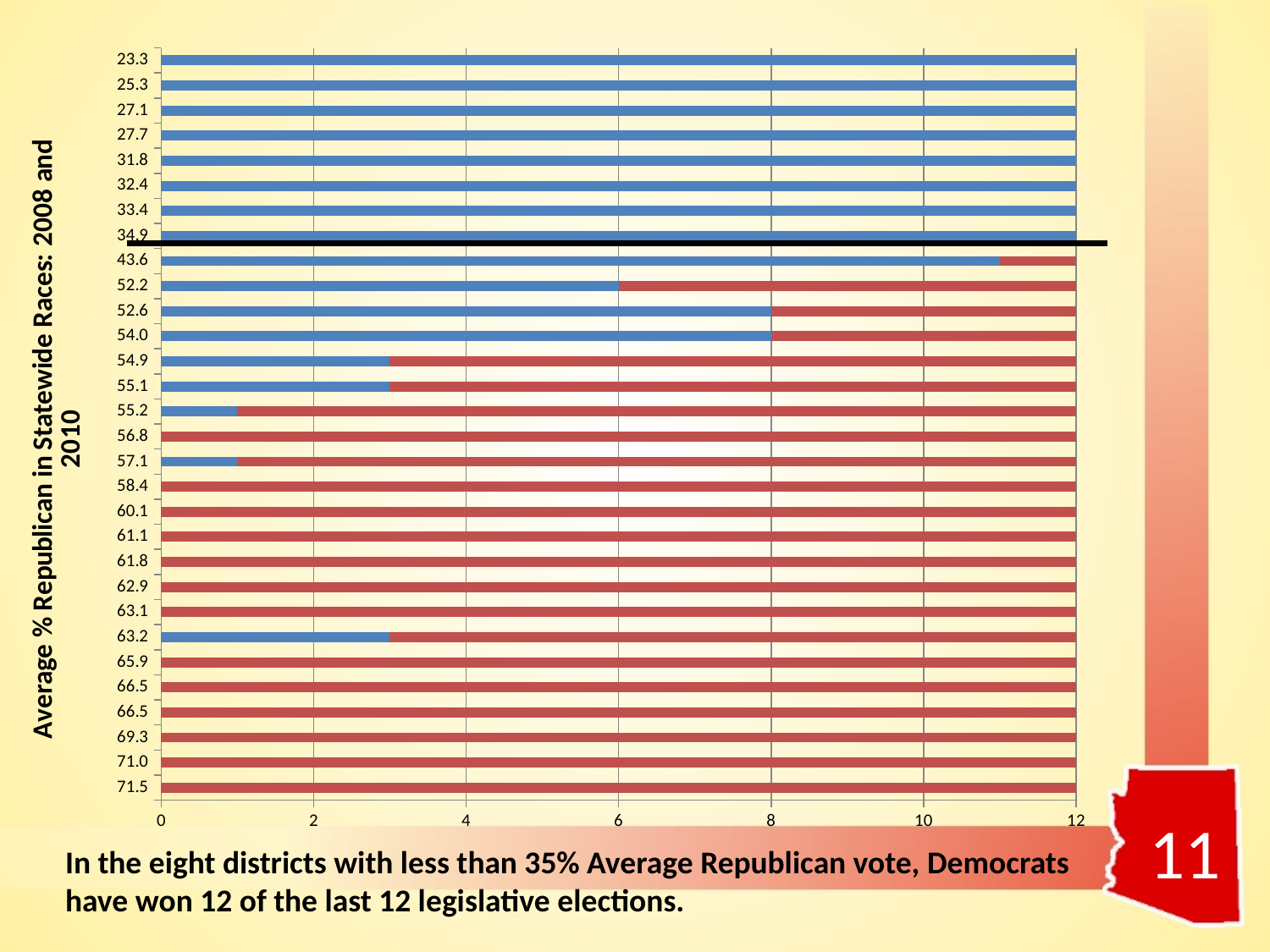
How many categories (bars) are plotted on the chart? 30 How long is the blue segment of the bar for the 52.2 category? 6 How long is the blue segment of the bar for the 52.6 category? 8 What is the total length of the bar for the 23.3 category? 12 Is the blue segment of the bar for the 54.9 category greater or less than 4? less What kind of chart is shown on the slide? bar chart What is the highest value shown on the horizontal axis of the chart? 12 How many bars on the chart are entirely blue? 8 How long is the blue segment of the bar for the 54.0 category? 8 Is the blue segment of the bar for the 43.6 category greater or less than 10? greater Which has the longer blue segment, the bar for 52.6 or the bar for 52.2? 52.6 What is the title of the vertical axis of the chart? Average % Republican in Statewide Races: 2008 and 2010